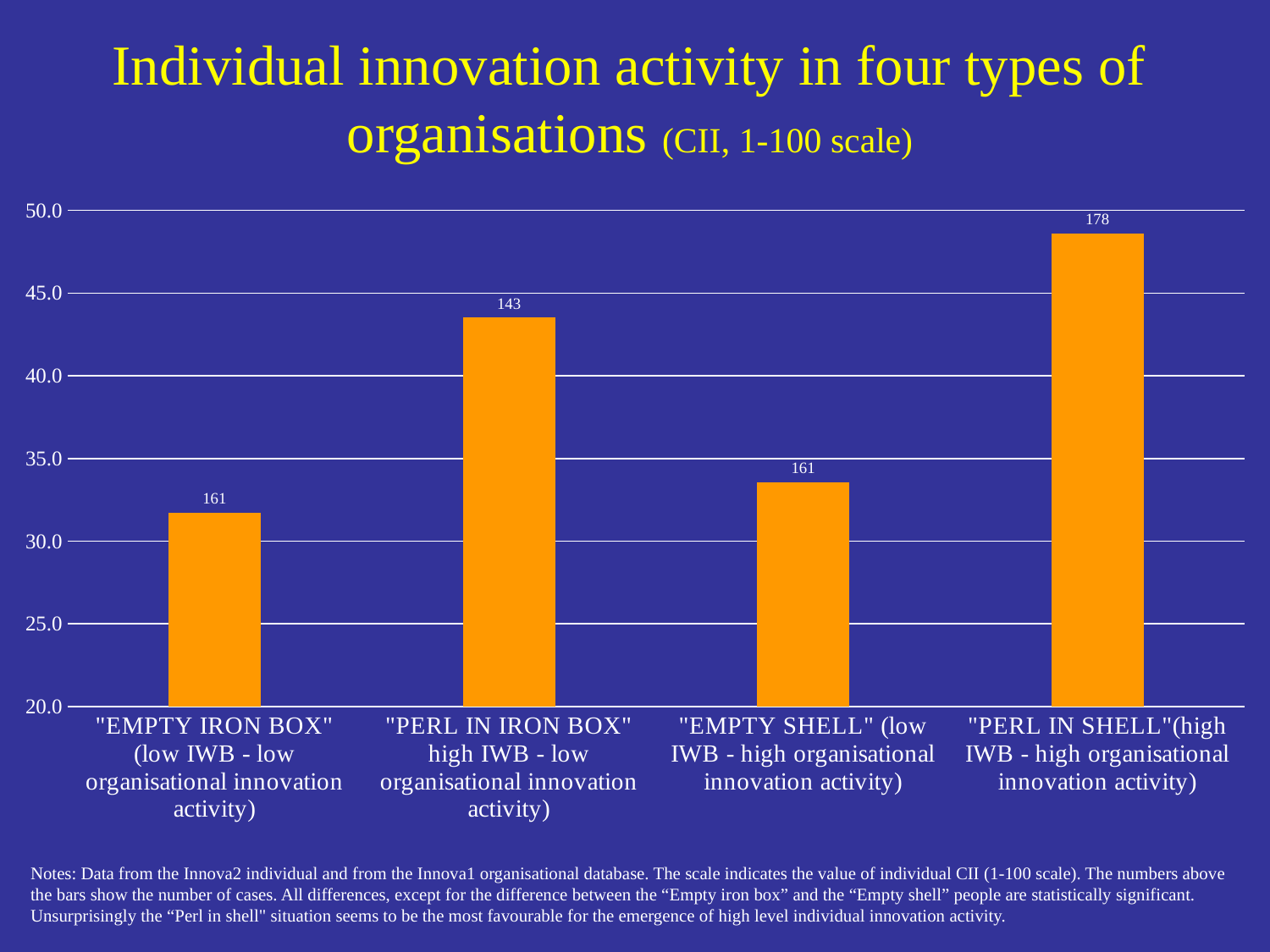
Is the CII value for "PERL IN SHELL" greater or less than 45.0? greater What kind of chart is shown on the slide? bar chart Is the CII value for "EMPTY IRON BOX" greater or less than 35.0? less Which type of organisation has the lowest individual innovation activity (CII) in the chart? "EMPTY IRON BOX" What number of cases is printed above the bar for "PERL IN IRON BOX"? 143 Which type of organisation has the highest individual innovation activity (CII) in the chart? "PERL IN SHELL" Is the CII value for "PERL IN IRON BOX" greater or less than 40.0? greater What number of cases is printed above the bar for "PERL IN SHELL"? 178 What colour are the bars in the chart? orange How many types of organisations (categories) are plotted in the chart? 4 Which has a higher CII value: "PERL IN IRON BOX" or "EMPTY SHELL"? "PERL IN IRON BOX"